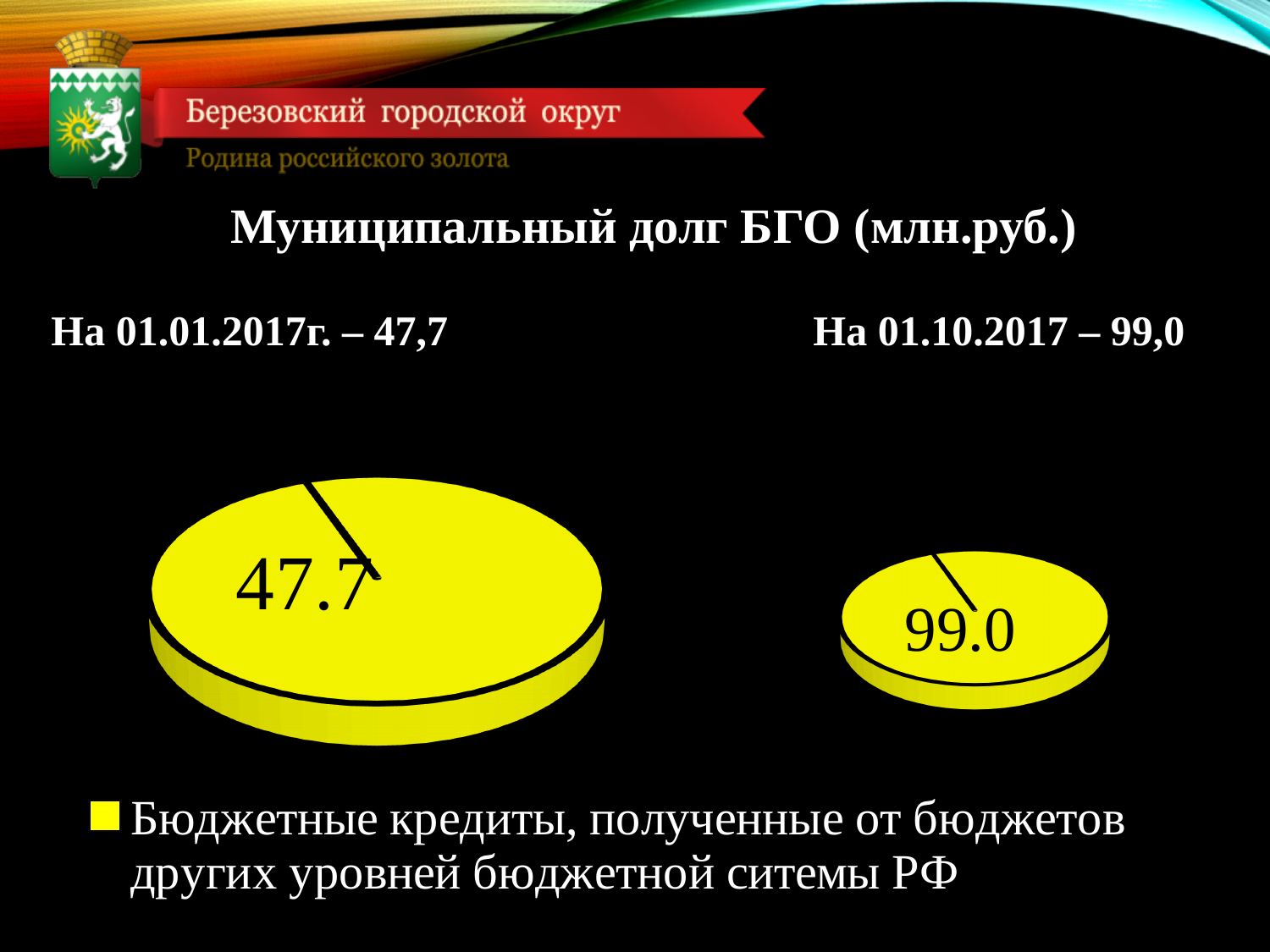
What colour are the pie slices on the slide? yellow How many pie charts are on the slide? 2 Which of the two pie charts shows the larger value, the left one (01.01.2017) or the right one (01.10.2017)? the right one (01.10.2017) What value is shown on the right pie chart (as of 01.10.2017)? 99.0 How many entries does the legend list? 1 What is the title above the pie charts? Муниципальный долг БГО (млн.руб.) What value is shown on the left pie chart (as of 01.01.2017)? 47.7 What share of the right pie chart does the single slice labelled 99.0 take up? 100% By how much does the value on the right pie chart (99.0) exceed the value on the left pie chart (47.7)? 51.3 What kind of chart is used on this slide to show the municipal debt? pie chart How many slices does the left pie chart contain? 1 Did the municipal debt rise or fall from 01.01.2017 to 01.10.2017? rise